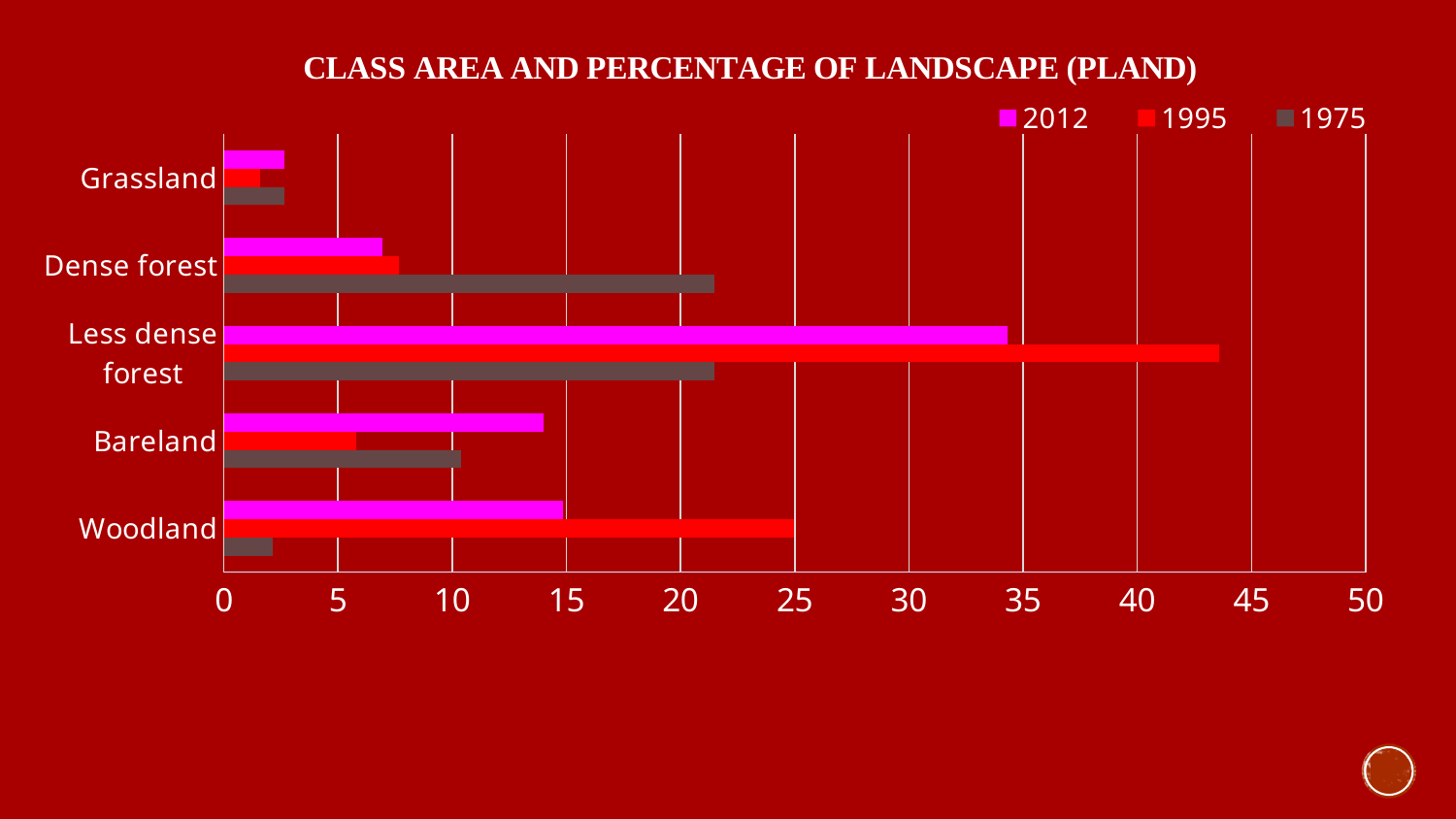
Is the 1995 value for Less dense forest greater or less than 40? greater For Bareland, which year has the larger value, 2012 or 1995? 2012 Is the 1975 value for Dense forest greater or less than 20? greater What is the title of the chart? CLASS AREA AND PERCENTAGE OF LANDSCAPE (PLAND) What kind of chart is shown on the slide? bar chart How many series does the legend list? 3 Which category has the highest value for 2012? Less dense forest For Dense forest, which year has the larger value, 1975 or 2012? 1975 Is the 1975 value for Woodland greater or less than 5? less Which category has the highest value for 1995? Less dense forest Which category has the lowest value for 1995? Grassland How many land cover categories are plotted on the chart? 5